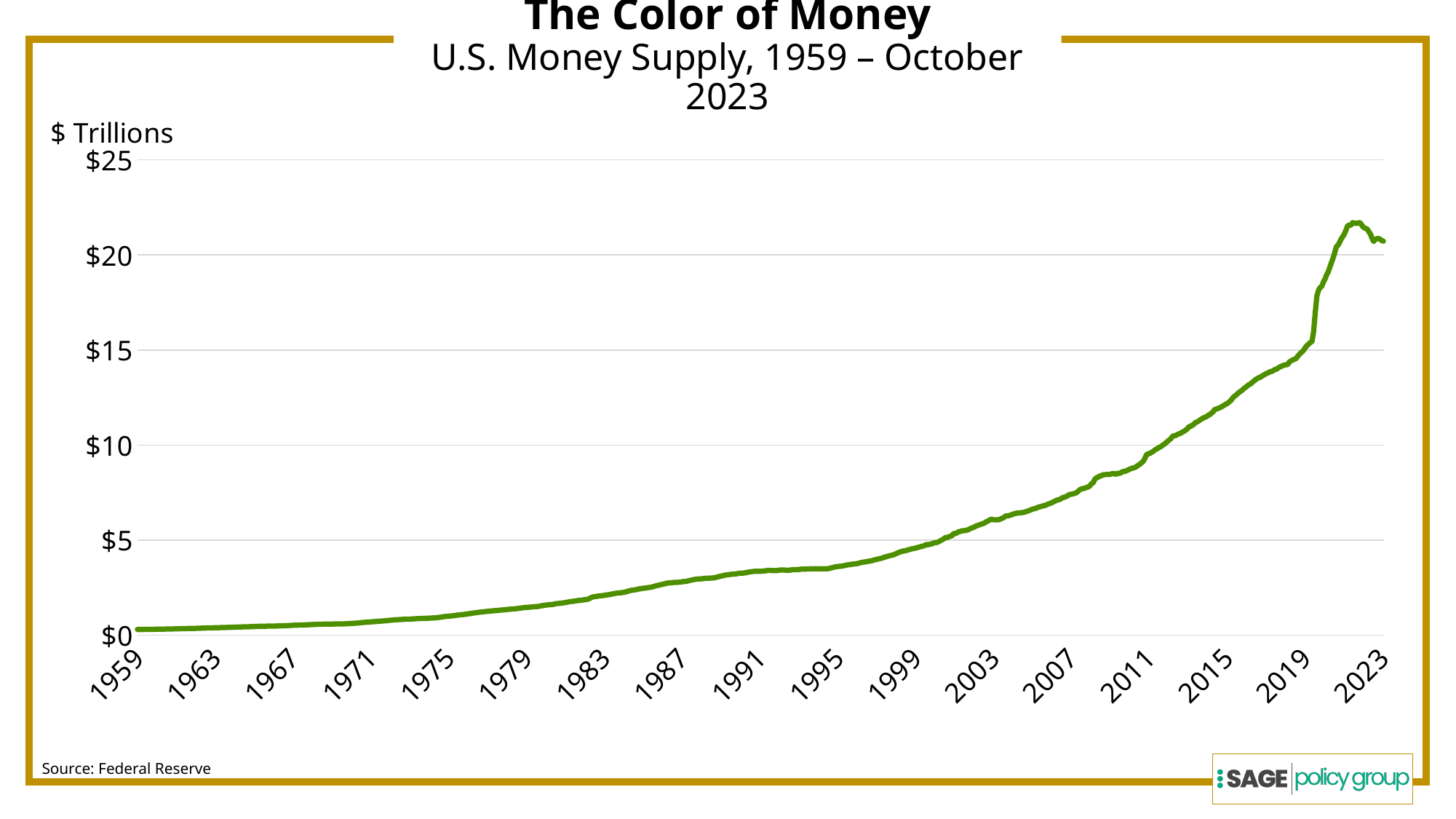
What unit is the y axis measured in? $ Trillions Is the value for 2015 greater or less than $10? greater Is the value for 2023 greater or less than $20? greater How many year labels are shown on the x axis? 17 What kind of chart is shown on the slide? line chart Does the money supply generally rise or fall from 1959 to 2019? rise Is the value for 2007 greater or less than $5? greater Which year has the larger money supply, 1991 or 2003? 2003 In which year shown on the x axis is the money supply lowest? 1959